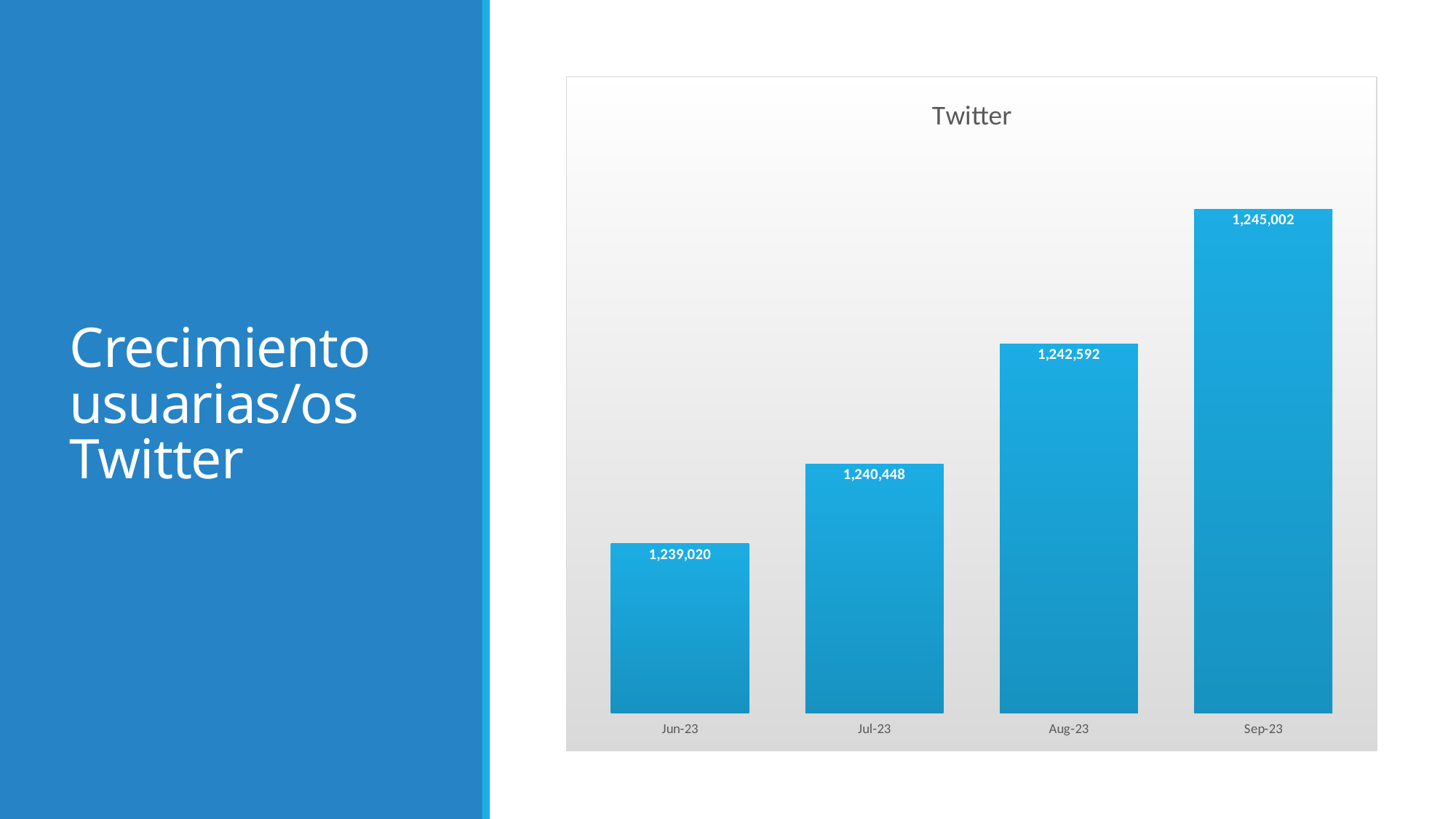
Which is larger, the value for Jul-23 or the value for Aug-23? Aug-23 Do the values rise or fall from Jun-23 to Sep-23? Rise What is the value for Sep-23? 1,245,002 How many months are shown on the chart? 4 What kind of chart is this? Bar chart What is the value for Jul-23? 1,240,448 What is the value for Aug-23? 1,242,592 What is the value for Jun-23? 1,239,020 Which month has the highest value? Sep-23 What is the difference between the values for Aug-23 and Jul-23? 2,144 What is the difference between the values for Sep-23 and Jun-23? 5,982 Which month has the lowest value? Jun-23